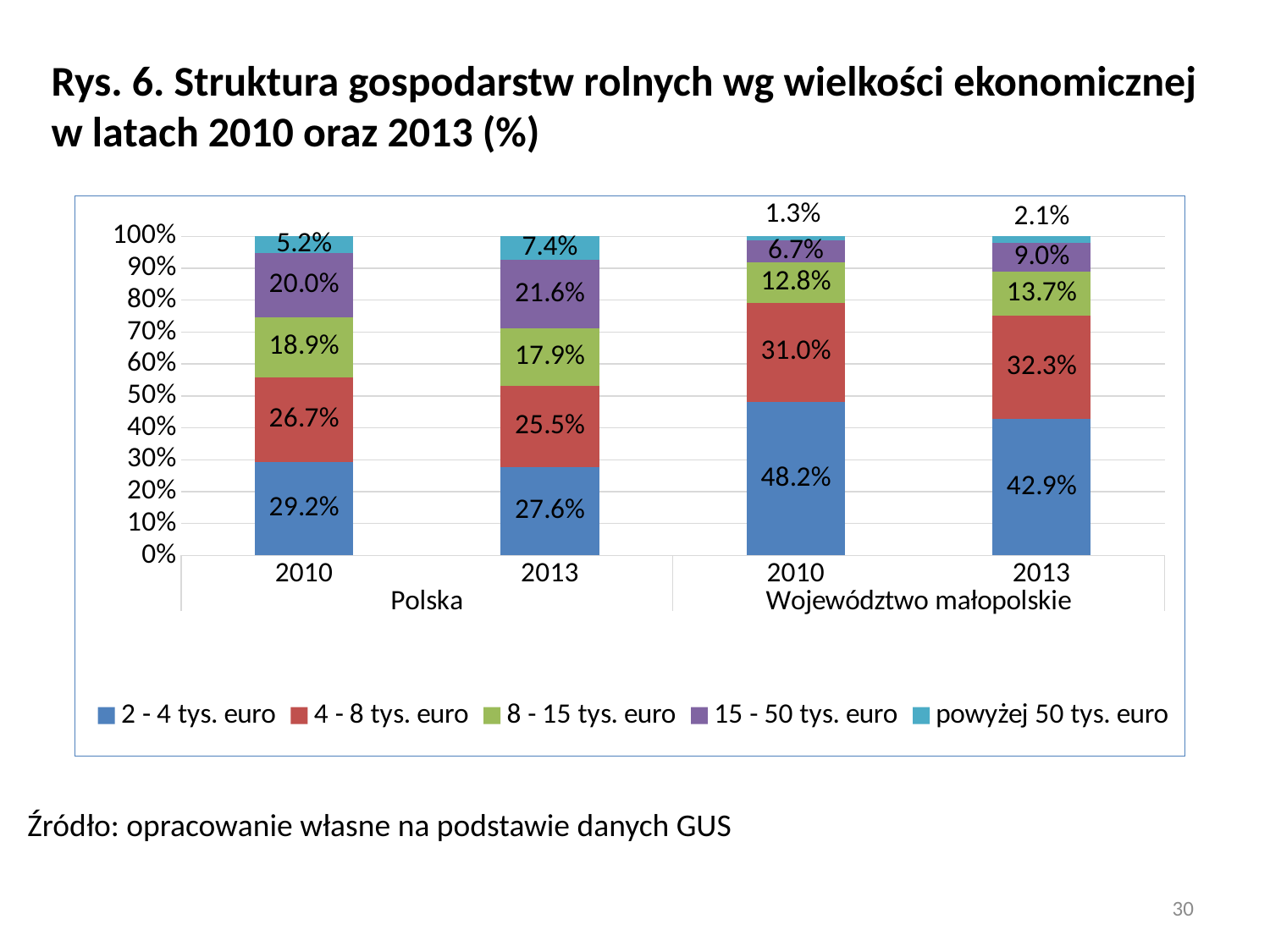
What kind of chart is shown on the slide? stacked bar chart Which bar has the highest share of farms with 2 - 4 tys. euro? Województwo małopolskie 2010 How many series does the legend list? 5 How many bars are plotted in the chart? 4 Did the share of farms with 15 - 50 tys. euro in Polska rise or fall from 2010 to 2013? rise What is the share of farms with 4 - 8 tys. euro in Polska in 2010? 26.7% What is the share of farms with 15 - 50 tys. euro in Polska in 2013? 21.6% Which is larger: the 8 - 15 tys. euro share in Polska in 2010 or in Województwo małopolskie in 2010? Polska 2010 What is the share of farms with powyżej 50 tys. euro in Województwo małopolskie in 2013? 2.1% What is the share of farms with 2 - 4 tys. euro in Województwo małopolskie in 2010? 48.2% Which bar has the lowest share of farms with powyżej 50 tys. euro? Województwo małopolskie 2010 What is the difference between the 2 - 4 tys. euro share in Województwo małopolskie in 2010 and in 2013? 5.3 percentage points